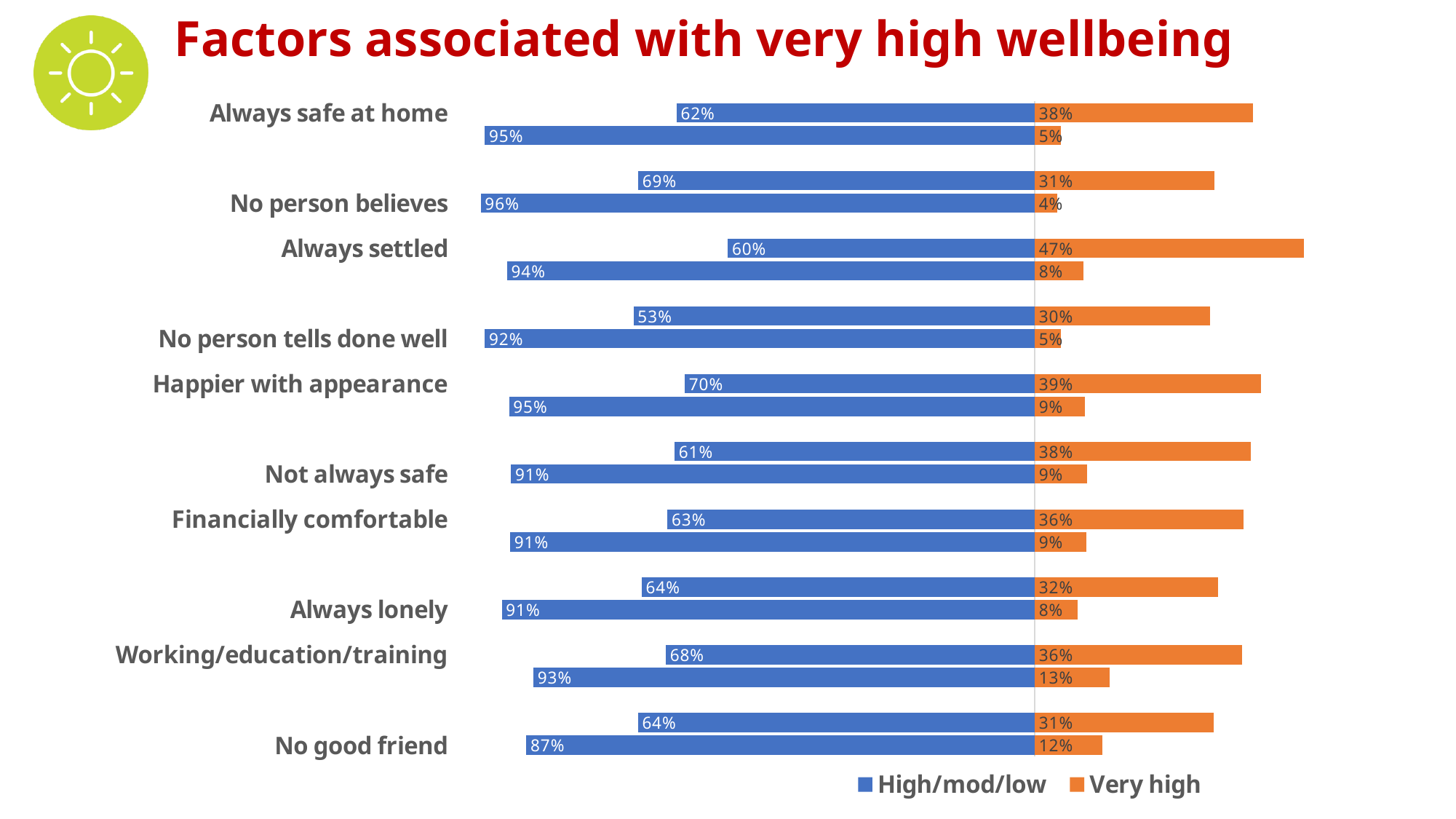
Which is larger: the Very high value in the upper bar for Happier with appearance or the Very high value in the upper bar for Always lonely? Happier with appearance How many category labels are shown on the vertical axis? 10 Which category's bar has the lowest Very high value? No person believes What is the difference between the Very high values of the upper and lower bars for Always safe at home? 33% How many series does the legend list? 2 What is the High/mod/low value in the upper bar for No person tells done well? 53% What is the High/mod/low value in the lower bar for No person believes? 96% What is the Very high value in the upper bar for Always settled? 47% What is the Very high value in the lower bar for Working/education/training? 13% What kind of chart is shown on the slide? bar chart Which colour represents the Very high series? orange Which category's bar has the highest Very high value? Always settled